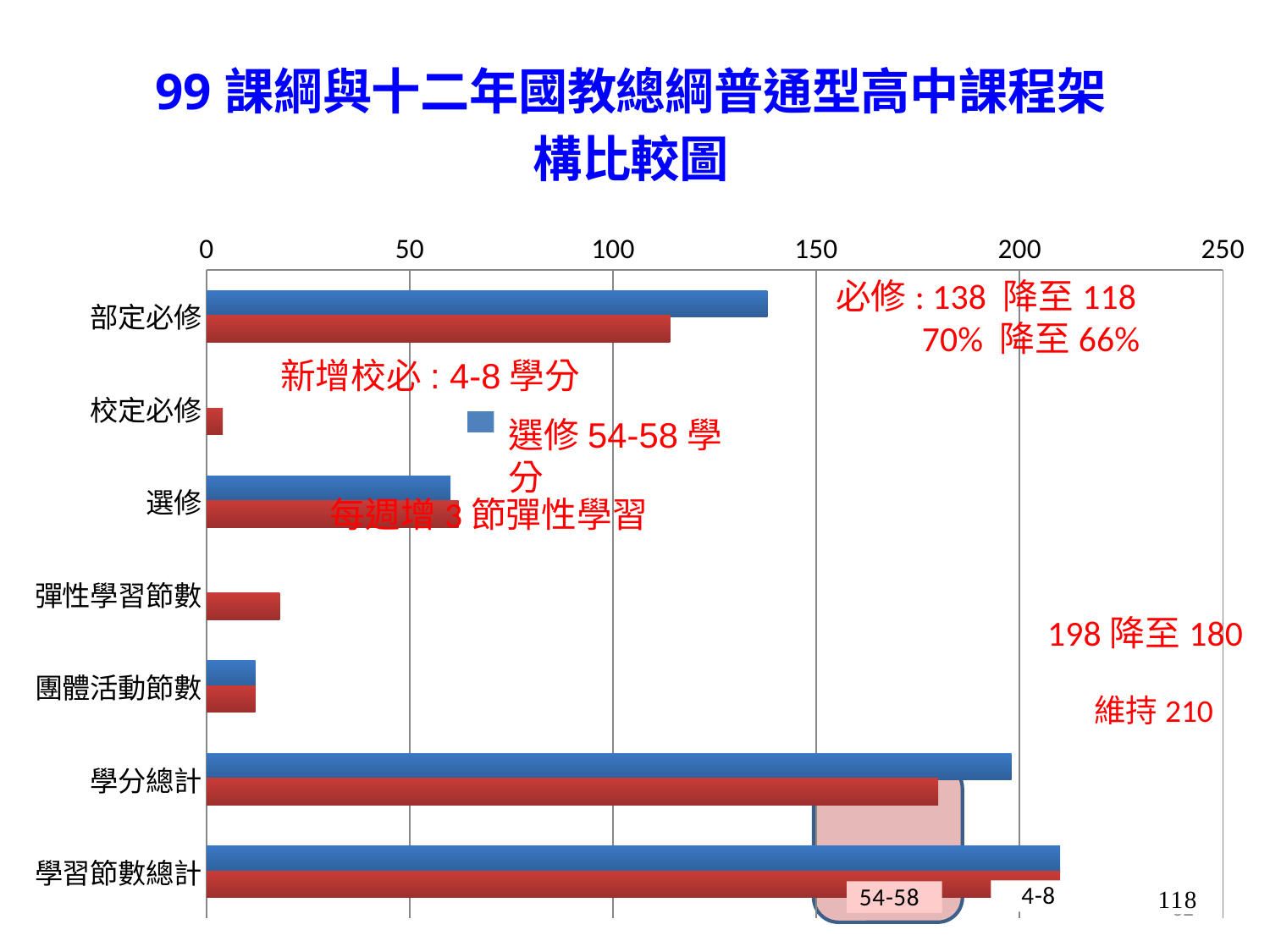
What is the difference between the blue-bar value (198) and the red-bar value (180) for 學分總計? 18 What is the title of the chart on the slide? 99 課綱與十二年國教總綱普通型高中課程架構比較圖 According to the annotation, what is the blue-bar value for 學分總計? 198 According to the annotation, what is the blue-bar value for 部定必修? 138 What type of chart is shown on the slide? bar chart For 部定必修, which bar is longer, the blue one or the red one? blue According to the annotation, what is the red-bar value for 學分總計? 180 Which category has the shortest red bar? 校定必修 How many categories are listed on the vertical axis of the chart? 7 How many data series (bar colours) are plotted in the chart? 2 Is the red-bar value for 彈性學習節數 greater or less than 50? less Which category has the longest blue bar? 學習節數總計